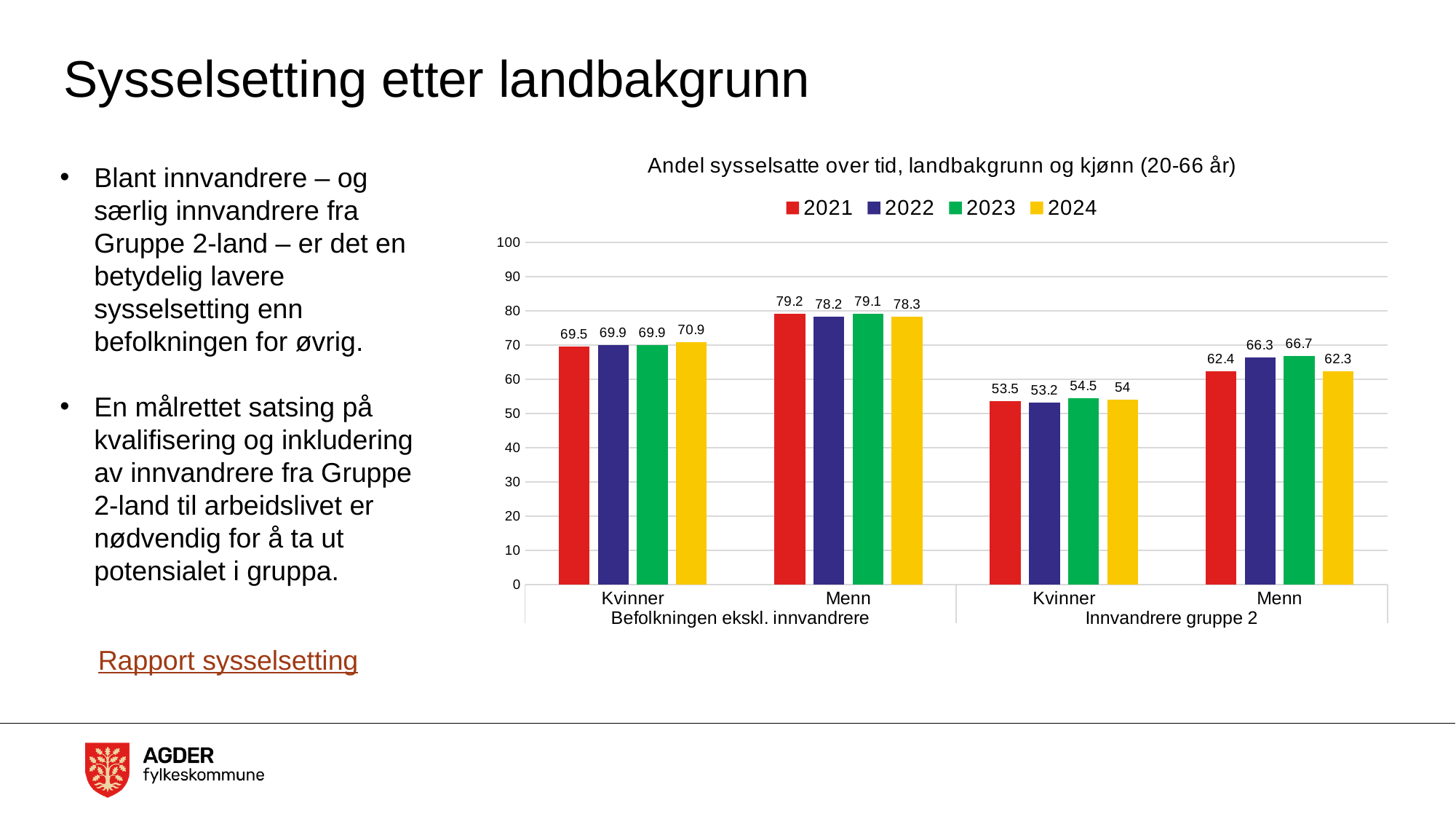
Which year has the highest value for Menn in the Innvandrere gruppe 2 group? 2023 What is the value for 2021 for Menn in the Innvandrere gruppe 2 group? 62.4 Do the values for Kvinner in Befolkningen ekskl. innvandrere rise or fall from 2021 to 2024? Rise Which is larger: the 2022 value for Kvinner in Befolkningen ekskl. innvandrere or the 2022 value for Menn in Innvandrere gruppe 2? Kvinner in Befolkningen ekskl. innvandrere Is the 2021 value for Menn in Befolkningen ekskl. innvandrere greater or less than 70? greater What is the title of the chart? Andel sysselsatte over tid, landbakgrunn og kjønn (20-66 år) What is the value for 2023 for Kvinner in the Innvandrere gruppe 2 group? 54.5 What is the difference between the 2024 values for Menn in Befolkningen ekskl. innvandrere and Menn in Innvandrere gruppe 2? 16 What is the value for 2024 for Kvinner in the Befolkningen ekskl. innvandrere group? 70.9 How many series does the legend list? 4 Which year has the lowest value for Kvinner in the Innvandrere gruppe 2 group? 2022 What kind of chart is shown on the slide? Bar chart